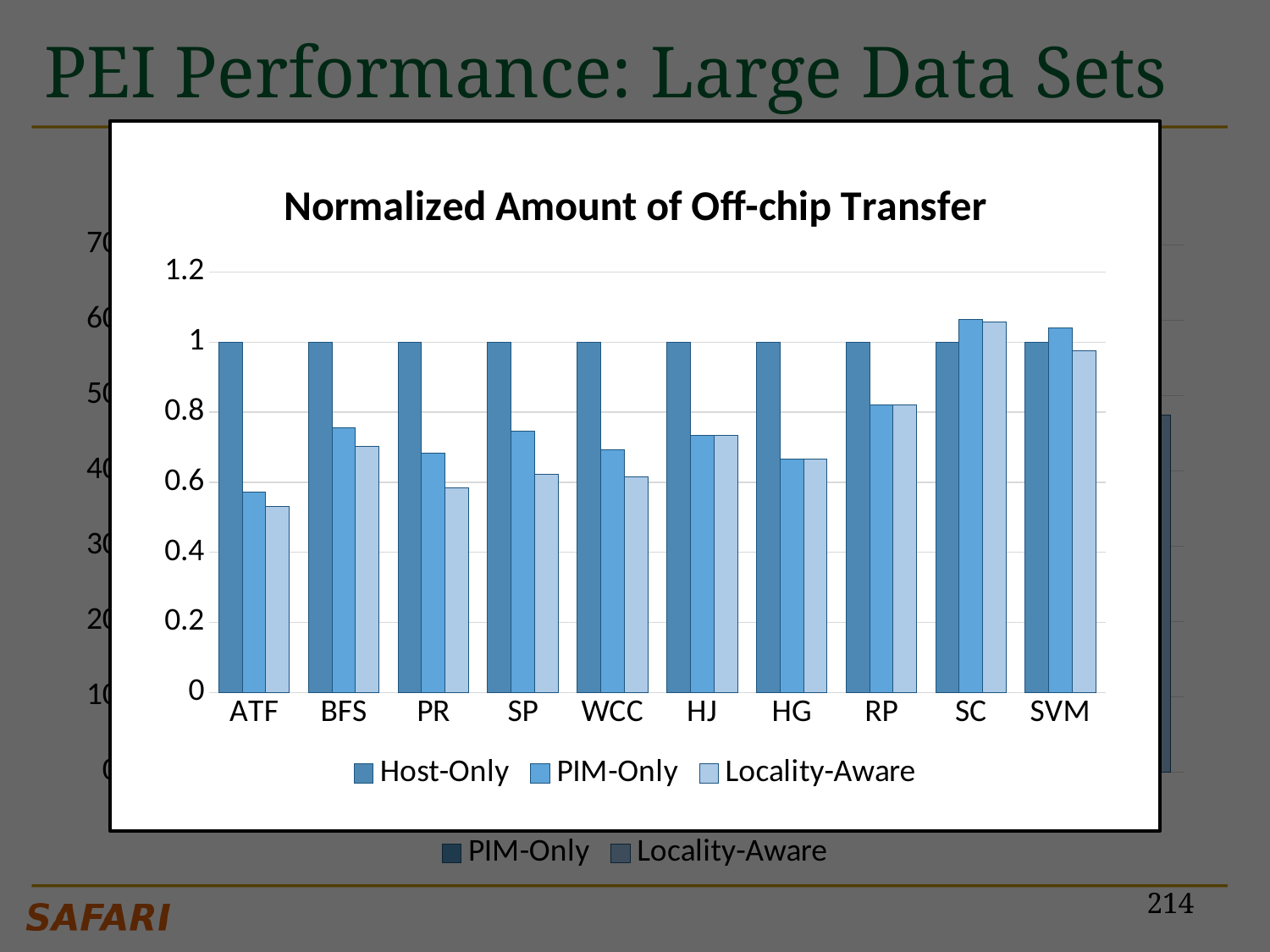
In the Normalized Amount of Off-chip Transfer chart, which is larger, the PIM-Only value for ATF or the PIM-Only value for BFS? BFS In the Normalized Amount of Off-chip Transfer chart, which category has the lowest PIM-Only value? ATF In the Normalized Amount of Off-chip Transfer chart, which series is listed first in the legend? Host-Only In the Normalized Amount of Off-chip Transfer chart, how many categories are shown on the x axis? 10 In the Normalized Amount of Off-chip Transfer chart, how many series does the legend list? 3 In the Normalized Amount of Off-chip Transfer chart, what is the Host-Only value for BFS? 1 In the Normalized Amount of Off-chip Transfer chart, is the Locality-Aware value for ATF greater or less than 0.6? less What is the title of the chart in the foreground? Normalized Amount of Off-chip Transfer In the Normalized Amount of Off-chip Transfer chart, is the PIM-Only value for HJ greater or less than 0.8? less In the Normalized Amount of Off-chip Transfer chart, what kind of chart is shown? bar chart In the Normalized Amount of Off-chip Transfer chart, is the PIM-Only value for SC greater or less than 1? greater In the Normalized Amount of Off-chip Transfer chart, which is larger, the Locality-Aware value for SC or the Locality-Aware value for SVM? SC